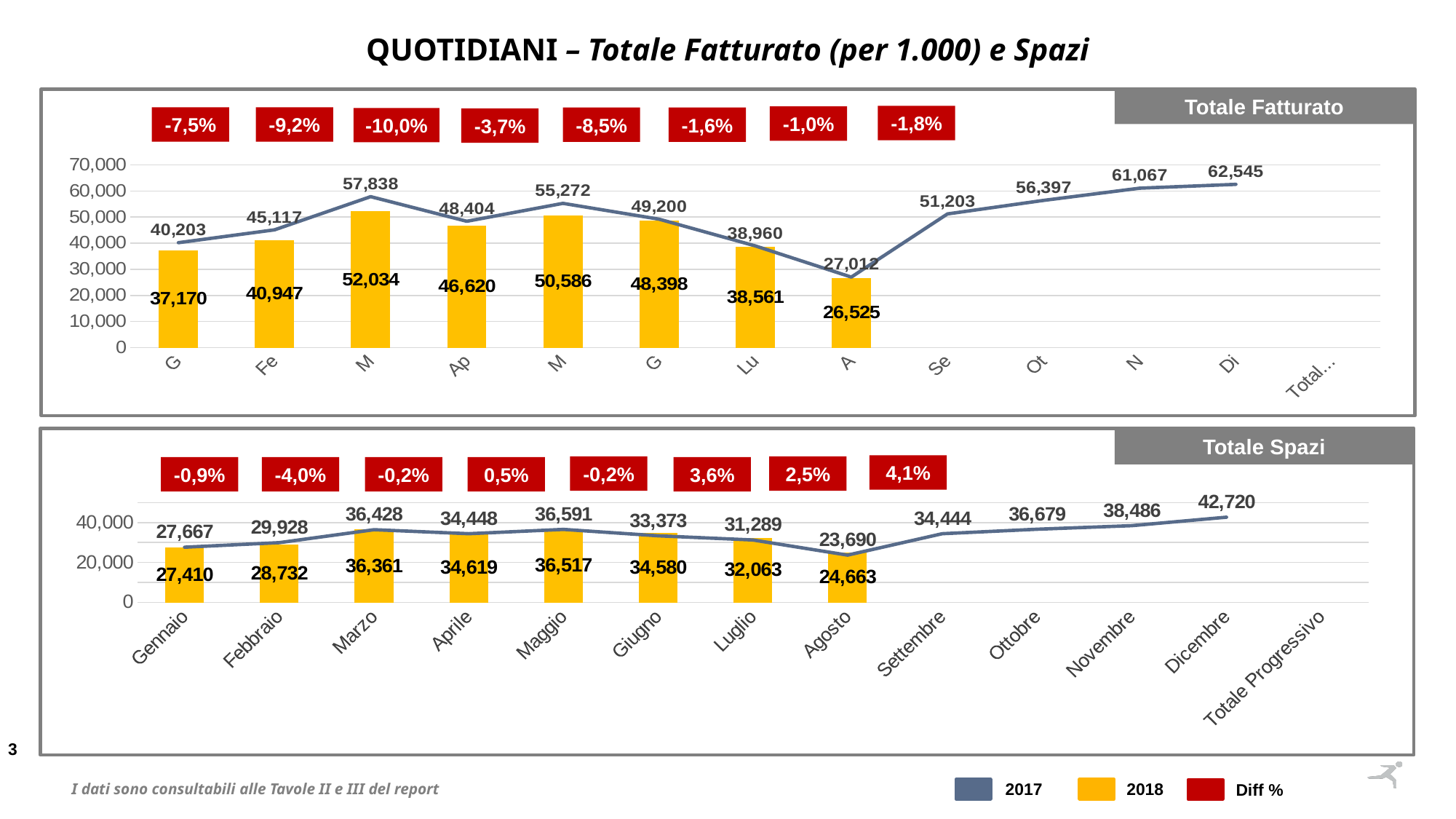
In the Totale Fatturato chart, what is the 2017 value for the last month, Di? 62,545 In the Totale Spazi chart, what is the difference between the 2017 and 2018 values for Gennaio? 257 In the Totale Fatturato chart, does the 2017 line rise or fall from Se to Di? rise In the Totale Fatturato chart, which category has the lowest 2018 bar? A In the Totale Spazi chart, which month has the highest 2017 value? Dicembre In the Totale Spazi chart, how many months have a 2018 bar? 8 In the Totale Spazi chart, what is the 2017 value for Agosto? 23,690 How many series does the legend at the bottom of the slide list? 3 In the Totale Fatturato chart, what is the Diff % shown above the Fe category? -9,2% In the Totale Spazi chart, what is the Diff % shown above Giugno? 3,6% In the Totale Spazi chart, for Luglio, which is larger: the 2017 value or the 2018 value? 2018 In the Totale Spazi chart, what is the 2018 value for Marzo? 36,361